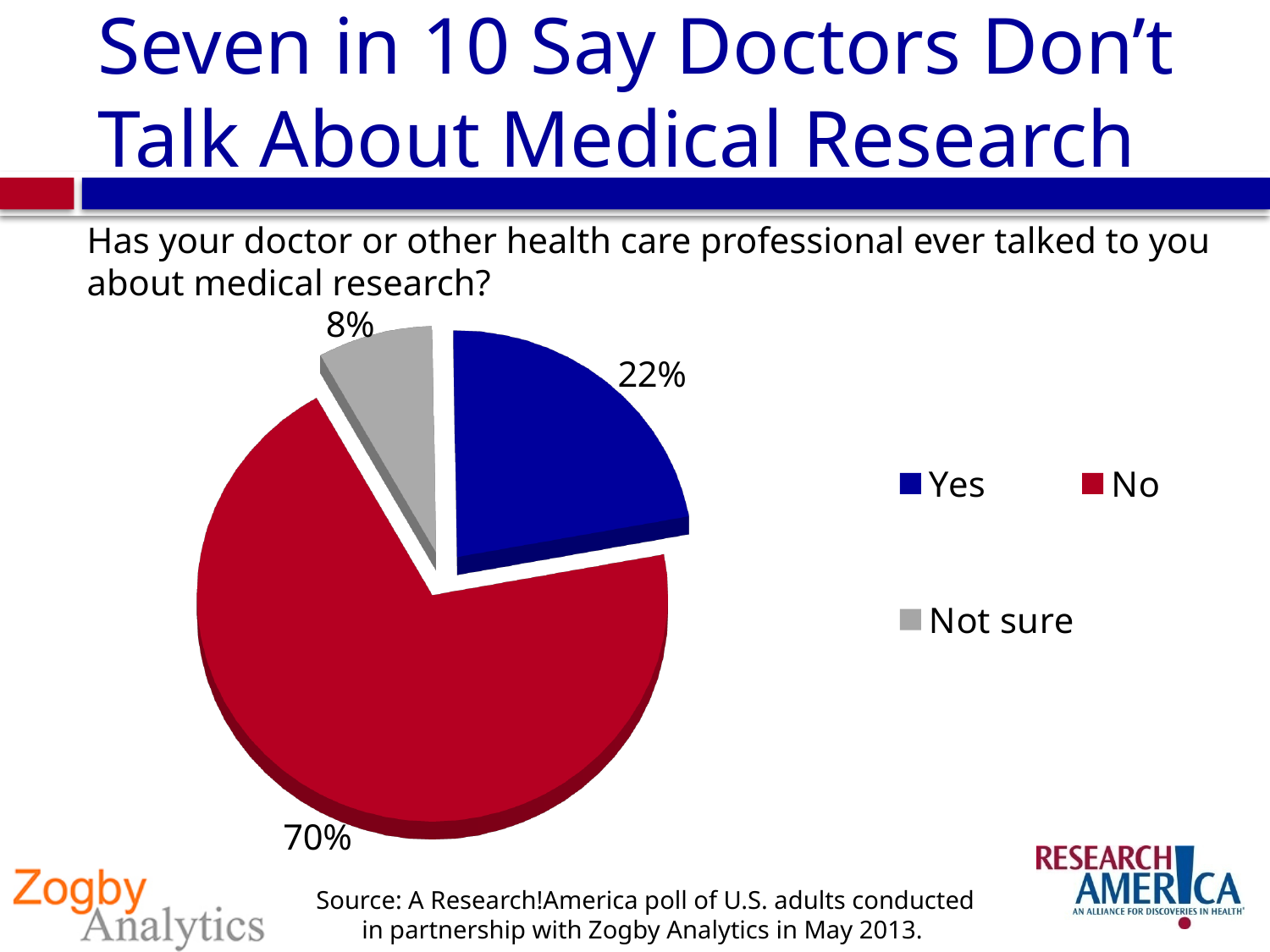
What kind of chart is shown on the slide? Pie chart How many slices does the pie chart have? 3 What survey question does the pie chart show responses to? Has your doctor or other health care professional ever talked to you about medical research? What percentage of respondents answered "Yes"? 22% Which response has the smallest share of the pie? Not sure What percentage of respondents answered "No"? 70% What colour is the "No" slice in the pie chart? Red What percentage of respondents answered "Not sure"? 8% What is the difference in percentage points between the "No" and "Yes" slices? 48 Which is larger, the "Yes" slice or the "Not sure" slice? Yes Which response has the largest share of the pie? No How many entries does the legend list? 3